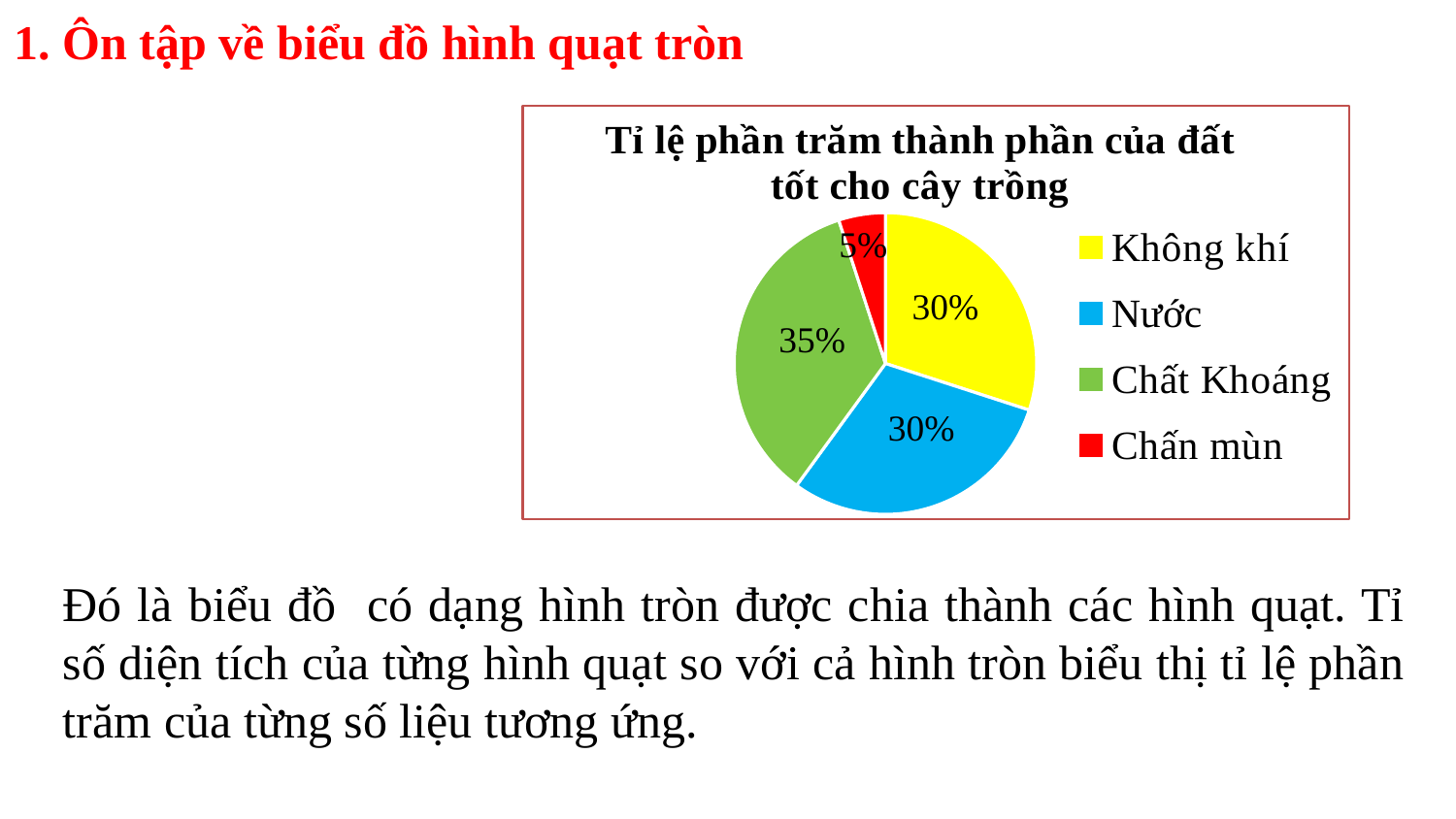
What colour is the slice for Chấn mùn? Red What percentage does the chart show for Không khí? 30% What percentage does the chart show for Chất Khoáng? 35% What percentage does the chart show for Chấn mùn? 5% How many categories does the pie chart show? 4 What kind of chart is shown on the slide? Pie chart Which category has the smallest slice of the pie? Chấn mùn What is the title of the chart? Tỉ lệ phần trăm thành phần của đất tốt cho cây trồng Which is larger, the slice for Chất Khoáng or the slice for Nước? Chất Khoáng What is the difference between the percentages for Chất Khoáng and Chấn mùn? 30% Which category has the largest slice of the pie? Chất Khoáng What percentage does the chart show for Nước? 30%